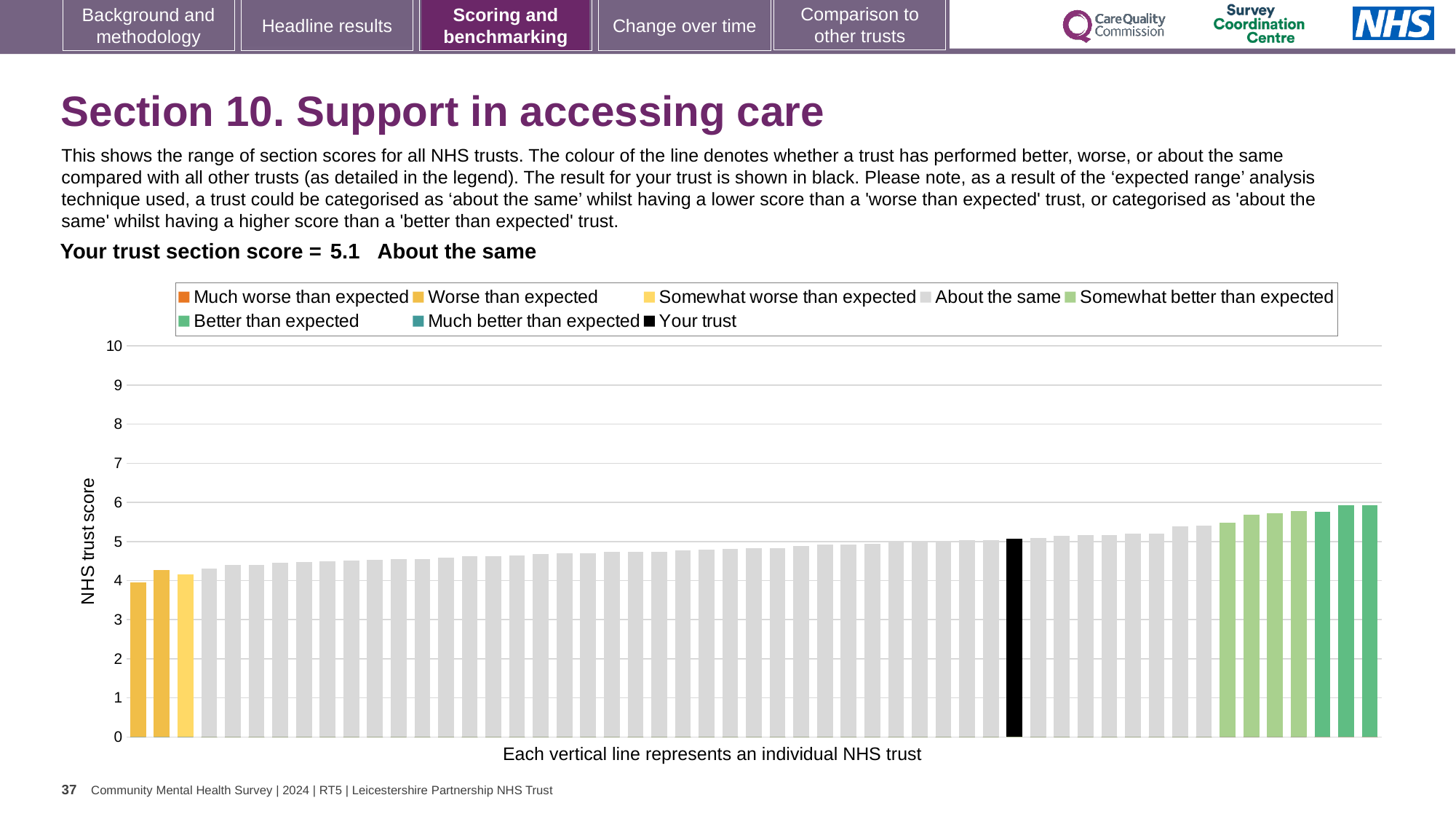
Do the bar values rise or fall from left to right along the x axis? rise How many bars are coloured as 'Better than expected'? 3 What kind of chart is shown on the slide? bar chart How many bars are coloured as 'Somewhat better than expected'? 4 What colour is the bar representing your trust? black What is the section score for your trust shown on the slide? 5.1 Is the value for your trust greater or less than 5? greater How is your trust categorised compared with other trusts? About the same How many entries does the chart legend list? 8 Is the value of the lowest bar greater or less than 5? less What is the label of the y axis? NHS trust score Is the value of the highest bar greater or less than 5? greater